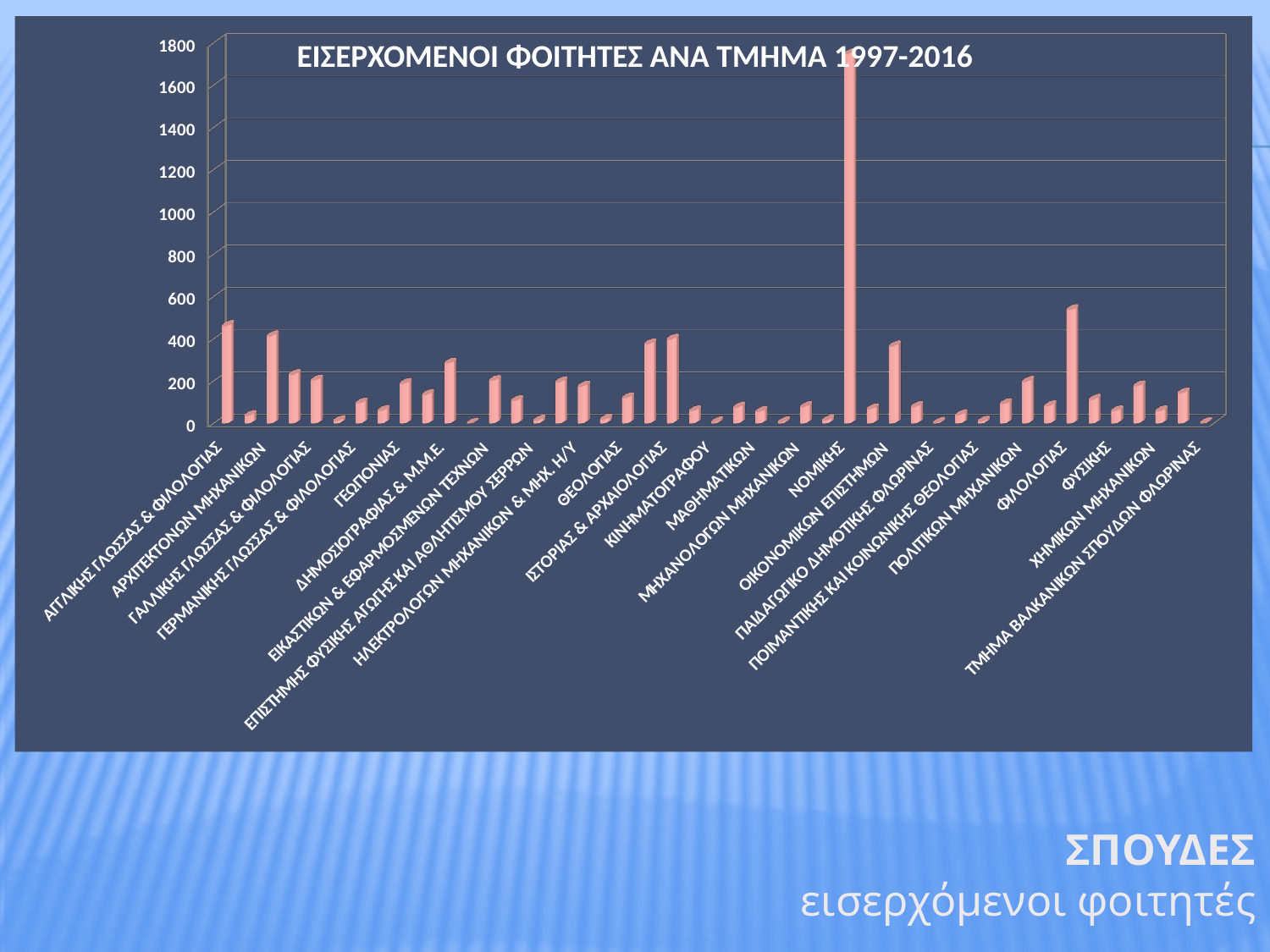
Which department has the highest number of incoming students in the chart? ΝΟΜΙΚΗΣ Which has a larger value, ΝΟΜΙΚΗΣ or ΦΙΛΟΛΟΓΙΑΣ? ΝΟΜΙΚΗΣ Is the value for ΦΙΛΟΛΟΓΙΑΣ greater or less than 400? greater What is the maximum value shown on the vertical axis of the chart? 1800 Is the value for ΘΕΟΛΟΓΙΑΣ greater or less than 200? less Which has a larger value, ΑΓΓΛΙΚΗΣ ΓΛΩΣΣΑΣ & ΦΙΛΟΛΟΓΙΑΣ or ΘΕΟΛΟΓΙΑΣ? ΑΓΓΛΙΚΗΣ ΓΛΩΣΣΑΣ & ΦΙΛΟΛΟΓΙΑΣ Is the value for ΝΟΜΙΚΗΣ greater or less than 1600? greater What type of chart is shown on the slide? Bar chart What is the title of the chart? ΕΙΣΕΡΧΟΜΕΝΟΙ ΦΟΙΤΗΤΕΣ ΑΝΑ ΤΜΗΜΑ 1997-2016